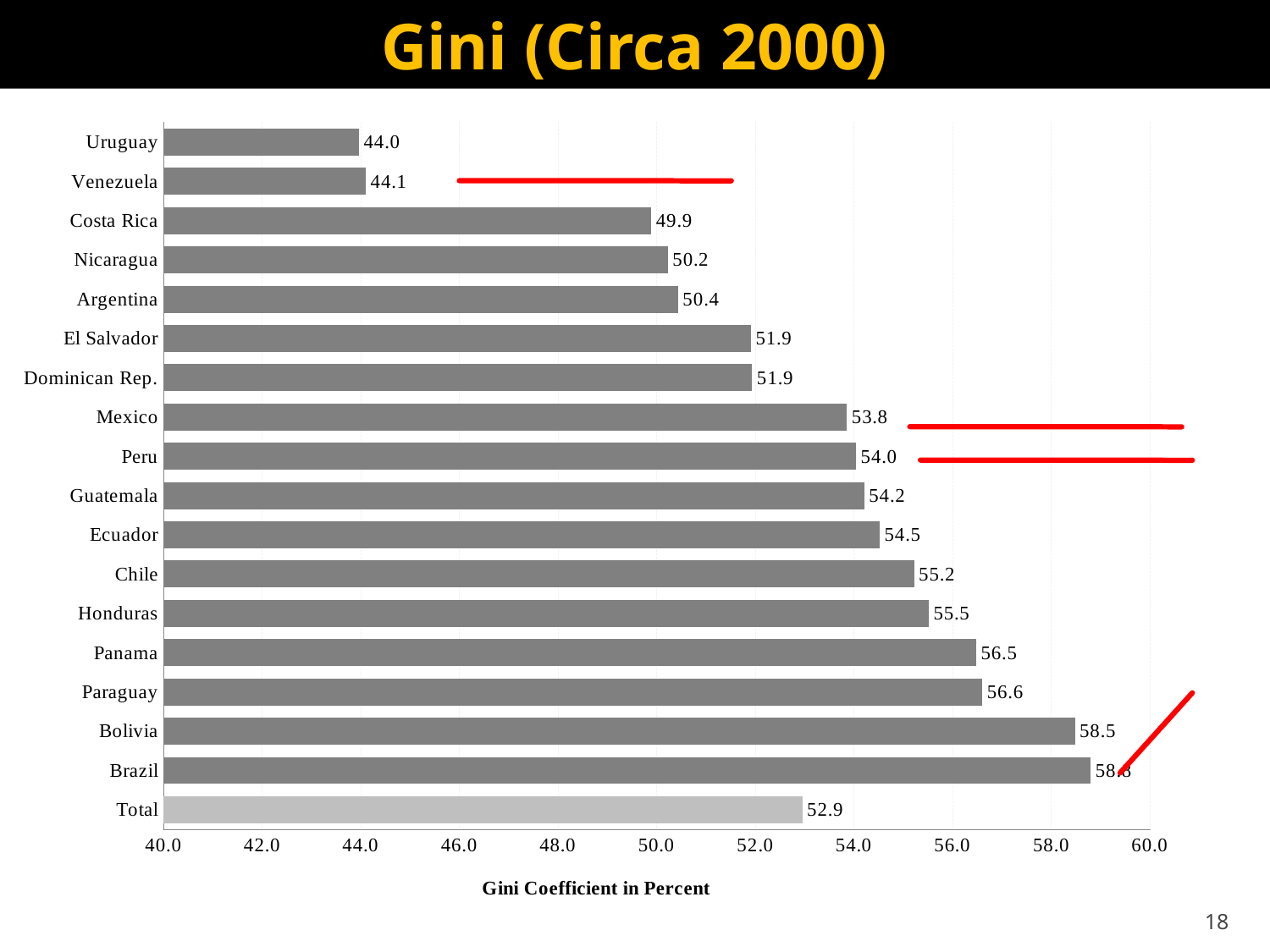
What is the difference between the Gini values of Paraguay and Uruguay? 12.6 What is the difference between the Gini values of Peru and Venezuela? 9.9 Is the value for Honduras greater or less than 54.0? greater What is the Gini coefficient shown for Bolivia? 58.5 What is the Gini coefficient shown for Mexico? 53.8 Which has a higher Gini coefficient, Chile or Argentina? Chile What is the Gini coefficient shown for Costa Rica? 49.9 Which country has the longest bar in the chart? Brazil What type of chart is shown on the slide? Bar chart What value is shown for the Total bar? 52.9 What is the label of the horizontal axis? Gini Coefficient in Percent How many countries are listed in the chart, excluding the Total bar? 17